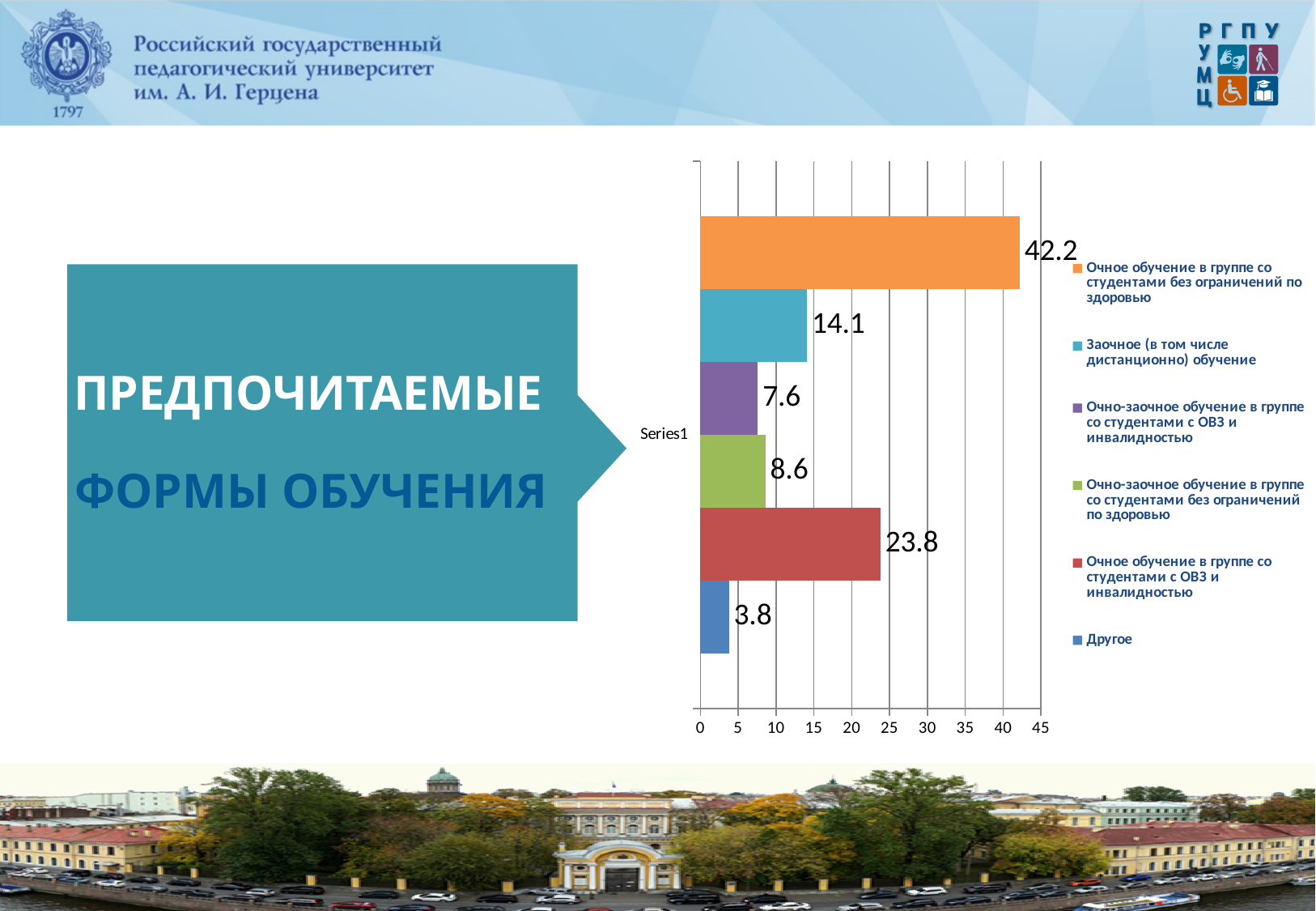
Which category has the lowest value? Другое Which category has the highest value? Очное обучение в группе со студентами без ограничений по здоровью What is the value for "Заочное (в том числе дистанционно) обучение"? 14.1 Is the value for "Очное обучение в группе со студентами с ОВЗ и инвалидностью" greater or less than 20? greater What is the value for "Очно-заочное обучение в группе со студентами с ОВЗ и инвалидностью"? 7.6 What colour is the bar for "Другое"? Blue What kind of chart is shown on the slide? Bar chart Which is larger: the value for "Очно-заочное обучение в группе со студентами без ограничений по здоровью" or for "Очно-заочное обучение в группе со студентами с ОВЗ и инвалидностью"? Очно-заочное обучение в группе со студентами без ограничений по здоровью What is the value for "Очное обучение в группе со студентами без ограничений по здоровью"? 42.2 What is the difference between the values for "Очное обучение в группе со студентами без ограничений по здоровью" and "Очное обучение в группе со студентами с ОВЗ и инвалидностью"? 18.4 What is the value for "Другое"? 3.8 How many bars are plotted in the chart? 6